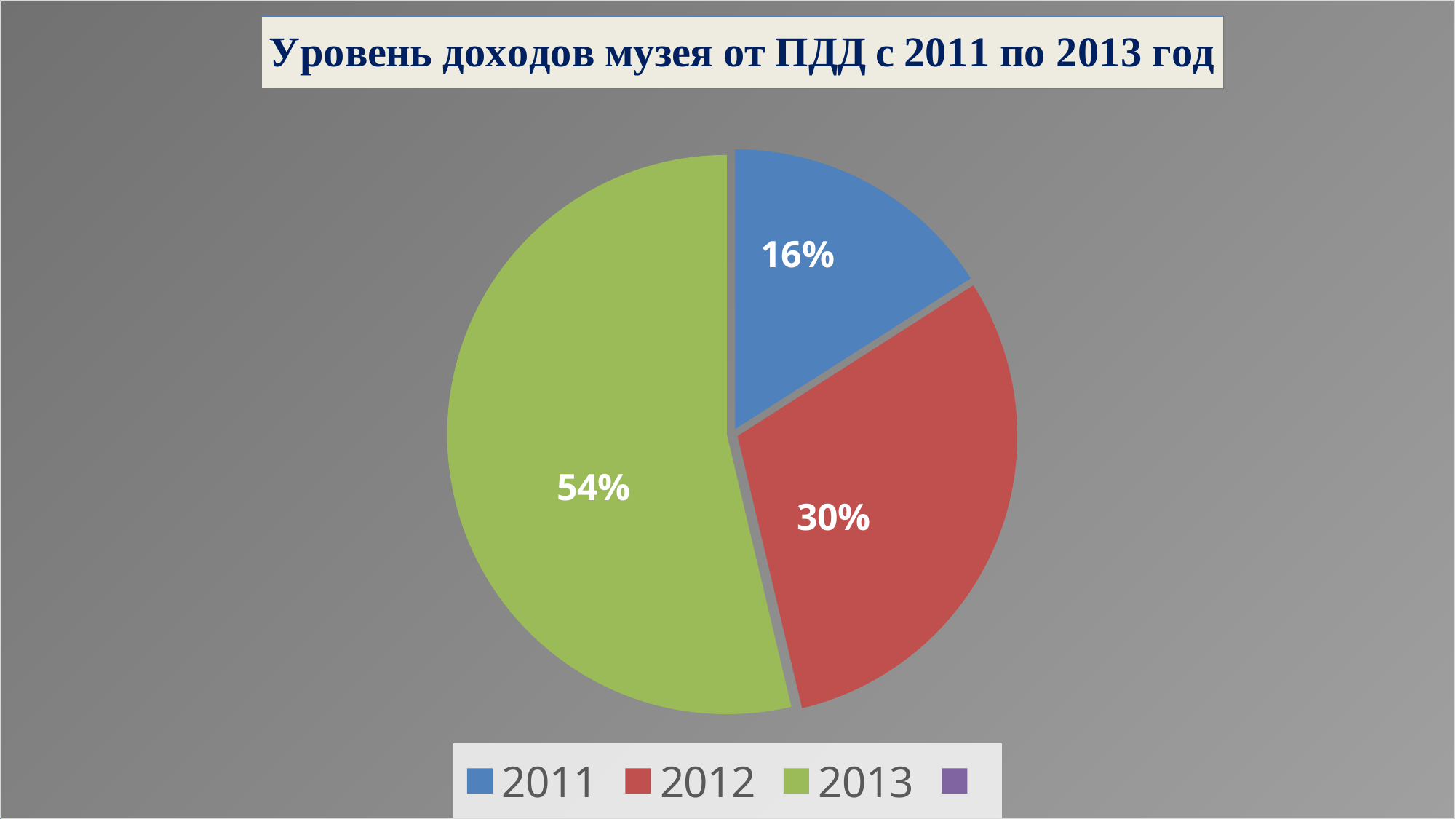
What colour is the slice for 2013? green What share of the pie does 2013 represent? 54% What is the difference in percentage points between the 2012 slice and the 2011 slice? 14 Which year has the largest slice of the pie? 2013 What is the difference in percentage points between the 2013 slice and the 2012 slice? 24 What is the title of the chart? Уровень доходов музея от ПДД с 2011 по 2013 год What share of the pie does 2011 represent? 16% Which slice is larger, 2011 or 2012? 2012 What share of the pie does 2012 represent? 30% Which year has the smallest slice of the pie? 2011 How many slices are shown in the pie chart? 3 What type of chart is shown on the slide? pie chart